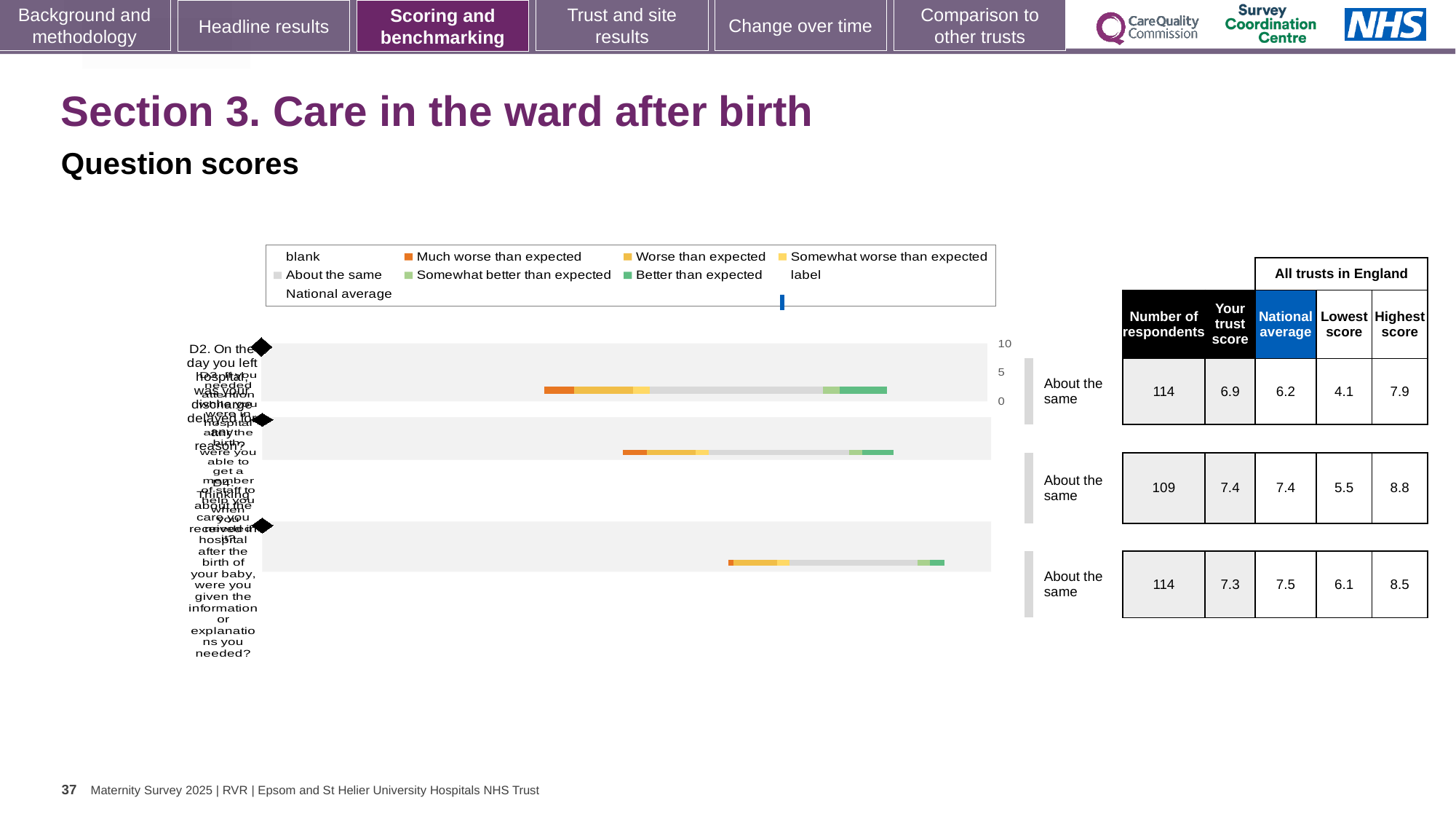
What kind of chart is shown on the slide? bar chart How many respondents answered the second question row? 109 For the third (bottom) question row, which is larger: the trust score or the national average? national average Which colour in the legend represents 'Much worse than expected'? orange Which colour in the legend represents 'Better than expected'? green What is the 'Your trust score' for the first (top) question row? 6.9 How many question bars are plotted in the chart? 3 What is the highest score among all trusts in England for the second question row? 8.8 What benchmark category is shown for all three question rows? About the same What is the national average for the first (top) question row? 6.2 What is the difference between the highest score and the lowest score for the second question row? 3.3 Which question row has the highest 'Your trust score'? the second row (7.4)